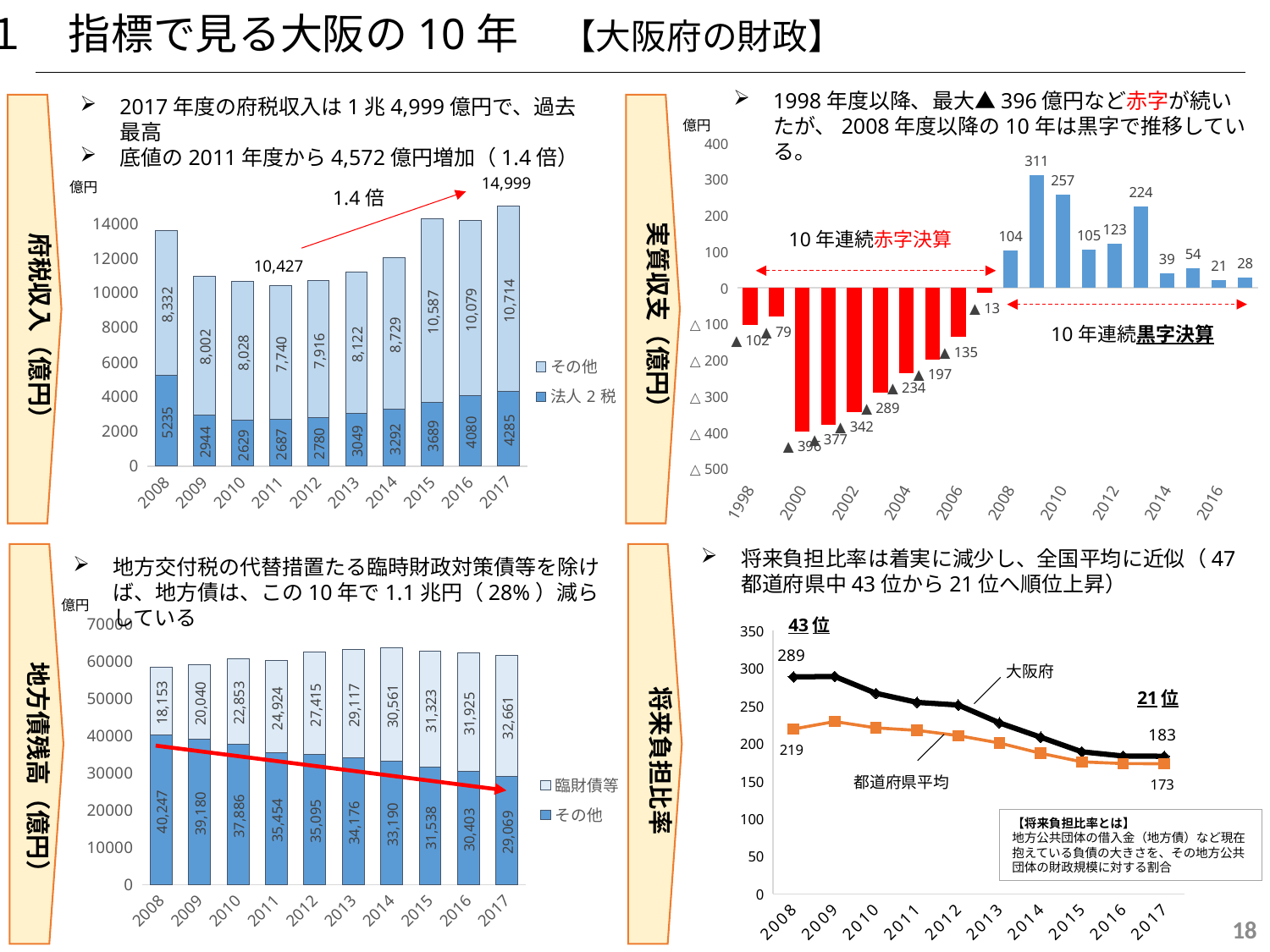
In the 実質収支（億円） chart at the top right, which year has the lowest value? 2000 In the 実質収支（億円） chart at the top right, what is the difference between the 2009 value and the 2010 value? 54 In the 府税収入（億円） chart at the top left, how many series does the legend list? 2 In the 将来負担比率 chart at the bottom right, what is the 大阪府 value for 2017? 183 In the 地方債残高（億円） chart at the bottom left, what is the 臨財債等 value for 2012? 27,415 In the 実質収支（億円） chart at the top right, what is the value for 2009? 311 In the 地方債残高（億円） chart at the bottom left, how many years are shown on the x axis? 10 In the 府税収入（億円） chart at the top left, what is the total labeled for 2017? 14,999 What kind of chart is the 将来負担比率 chart at the bottom right? line chart In the 府税収入（億円） chart at the top left, what is the 法人2税 value for 2008? 5235 In the 地方債残高（億円） chart at the bottom left, does the その他 series rise or fall from 2008 to 2017? fall In the 府税収入（億円） chart at the top left, what is the その他 value for 2017? 10,714